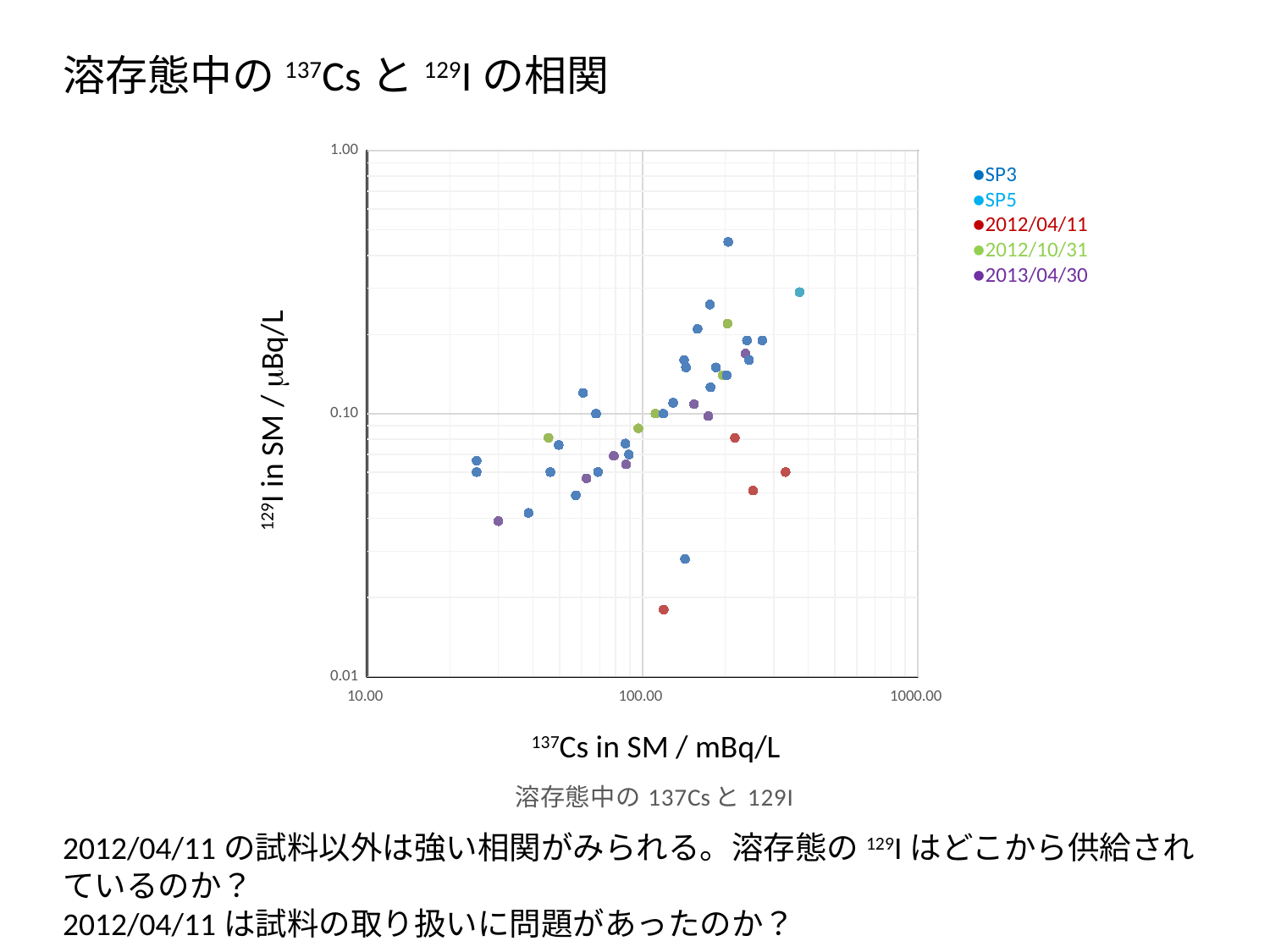
Is the y value of the lowest 2012/04/11 point greater or less than 0.10? less Which series contains the point with the lowest 129I value? 2012/04/11 Which series contains the point with the highest 129I value? SP3 What kind of chart is shown on the slide? scatter plot Overall, do the 129I values tend to rise or fall as 137Cs increases along the x axis? rise How many series does the legend list? 5 Is the y value of the SP5 point greater or less than 0.10? greater What is the label of the x axis? 137Cs in SM / mBq/L What is the label of the y axis? 129I in SM / μBq/L Is the x value of the SP5 point greater or less than 100.00? greater